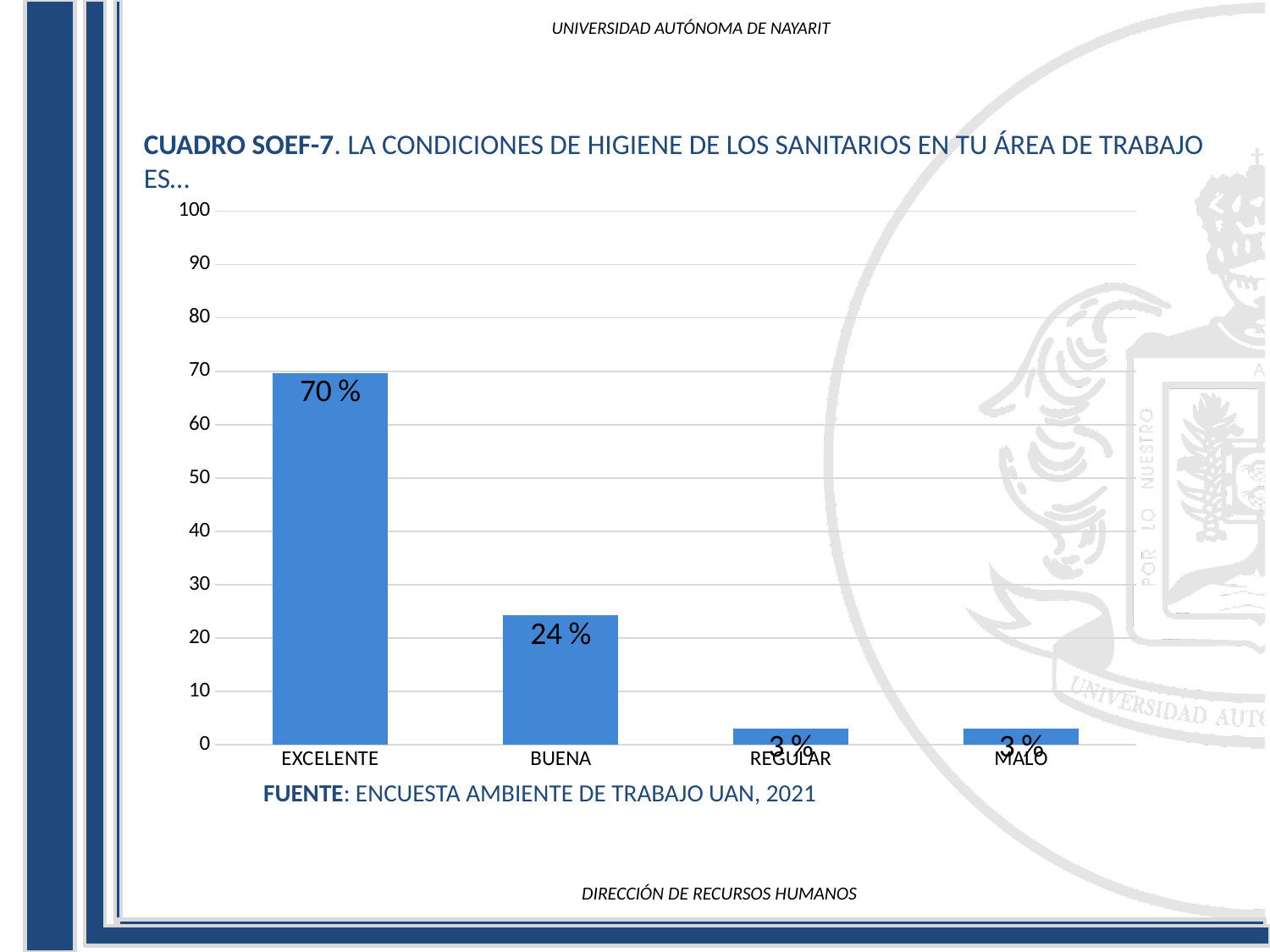
How many categories are shown on the x axis? 4 What is the value for EXCELENTE? 70 % Is the value for EXCELENTE greater or less than 60? greater Is the value for BUENA greater or less than 30? less Which is larger, the value for BUENA or the value for MALO? BUENA Do the values rise or fall from left to right along the x axis? fall What source is cited below the chart? ENCUESTA AMBIENTE DE TRABAJO UAN, 2021 What kind of chart is shown on the slide? bar chart What is the value for BUENA? 24 % What is the difference between the values for EXCELENTE and BUENA? 46 % Which category has the highest value? EXCELENTE What is the value for REGULAR? 3 %